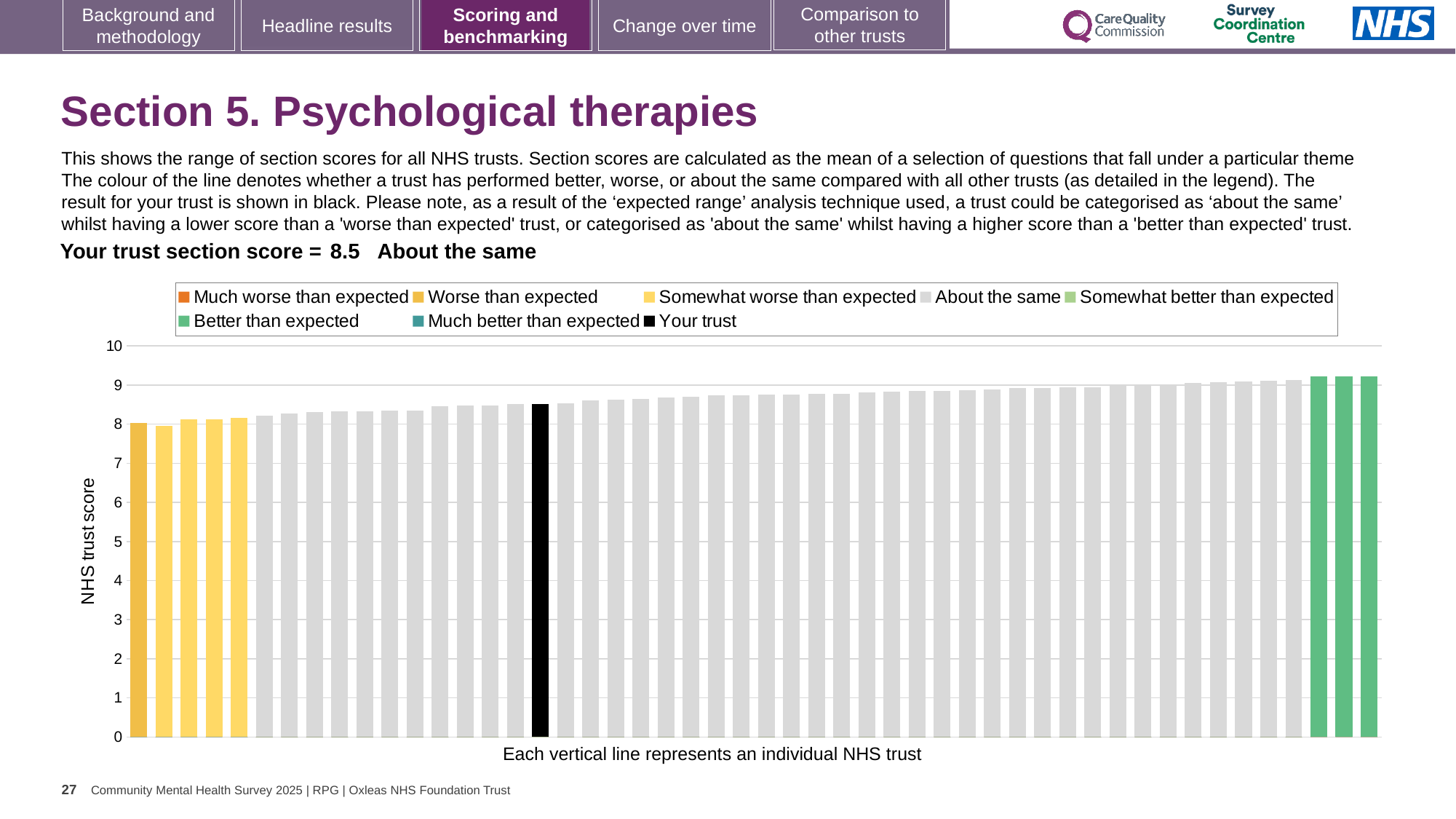
How many entries does the chart legend list? 8 What is the label on the vertical axis of the chart? NHS trust score Is the value of the highest bar in the chart greater or less than 10? less Is the value of the lowest bar in the chart greater or less than 7? greater What does each vertical line in the chart represent, according to the caption below the chart? an individual NHS trust What is the section score for your trust shown on the slide? 8.5 Which category is your trust placed in for Section 5. Psychological therapies? About the same Do the bar values rise or fall from left to right across the chart? rise How many bars in the chart are coloured green (Better than expected)? 3 What kind of chart is shown on the slide? bar chart Is the value for your trust (the black bar) greater or less than 8? greater